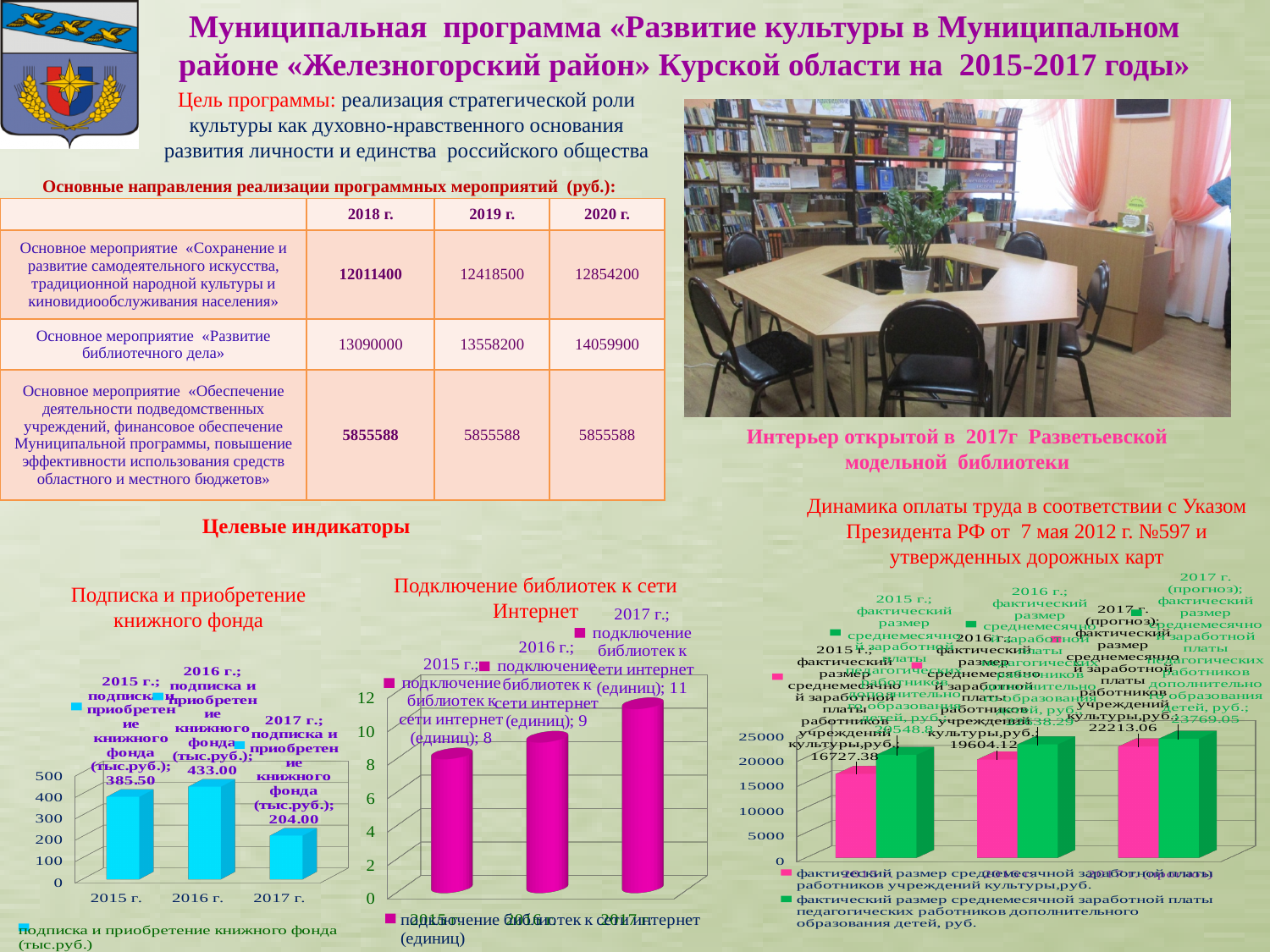
In the chart 'Подключение библиотек к сети Интернет', what is the value for 2015 г.? 8 In the chart 'Подписка и приобретение книжного фонда', what is the difference between the 2015 г. and 2017 г. values? 181.50 In the chart 'Подключение библиотек к сети Интернет', do the values rise or fall from 2015 г. to 2017 г.? rise How many series does the legend of the chart 'Динамика оплаты труда' list? 2 In the chart 'Подписка и приобретение книжного фонда', what is the value for 2017 г.? 204.00 In the chart 'Динамика оплаты труда', what is the фактический размер среднемесячной заработной платы работников учреждений культуры for 2017 г. (прогноз)? 22213.06 How many years are shown on the x axis of the chart 'Подключение библиотек к сети Интернет'? 3 In the chart 'Подключение библиотек к сети Интернет', what is the value for 2017 г.? 11 In the chart 'Подписка и приобретение книжного фонда', what is the value for 2016 г.? 433.00 In the chart 'Динамика оплаты труда', which is larger for 2016 г.: the salary of работников учреждений культуры or of педагогических работников дополнительного образования детей? педагогических работников дополнительного образования детей In the chart 'Динамика оплаты труда', what is the фактический размер среднемесячной заработной платы работников учреждений культуры for 2015 г.? 16727.38 In the chart 'Подписка и приобретение книжного фонда', which year has the highest value? 2016 г.